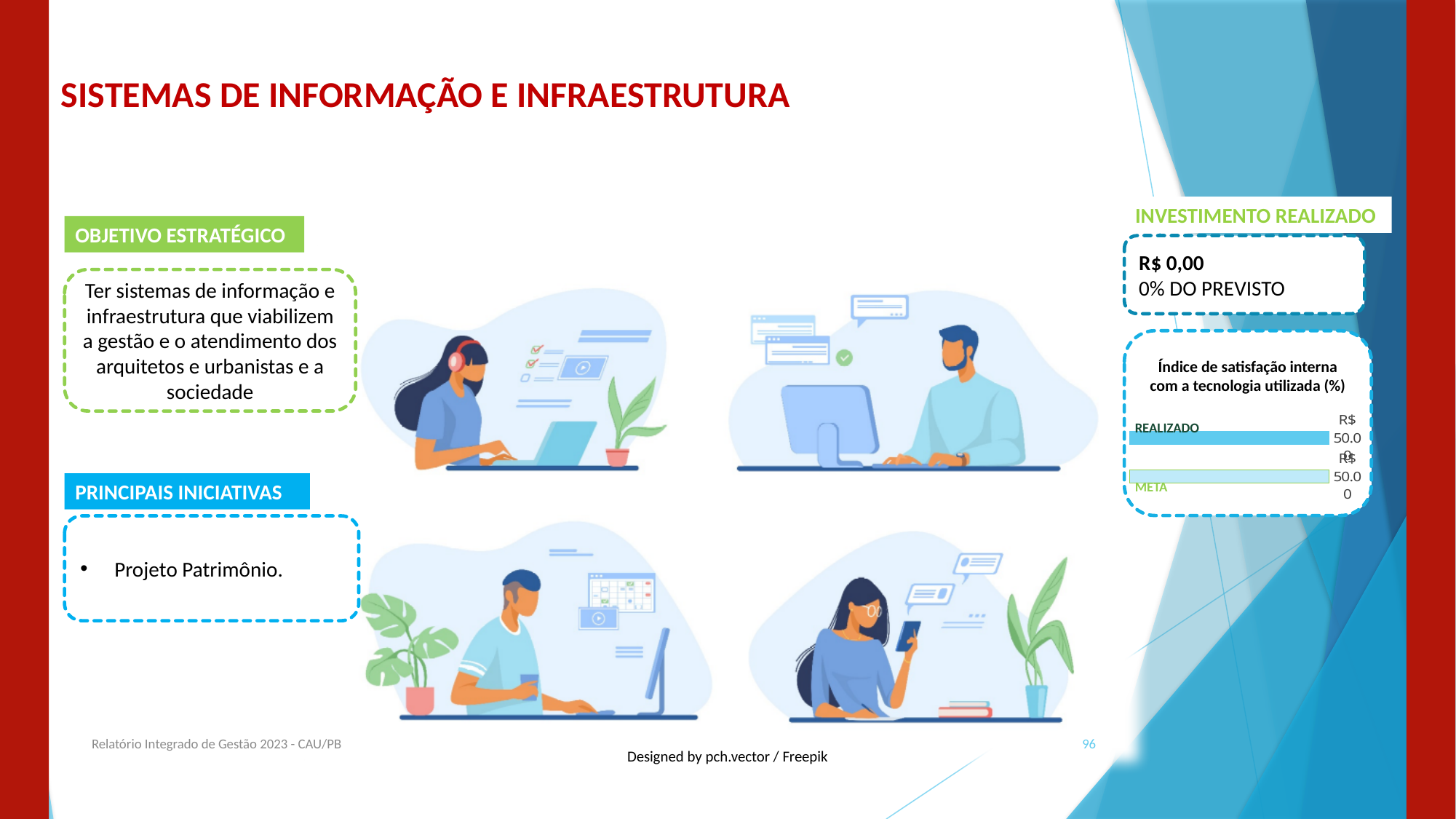
In the 'Índice de satisfação interna com a tecnologia utilizada (%)' chart, is the REALIZADO bar longer, shorter, or the same length as the META bar? the same length How many bars does the 'Índice de satisfação interna com a tecnologia utilizada (%)' chart show? 2 What kind of chart is shown under 'Índice de satisfação interna com a tecnologia utilizada (%)'? bar chart What is the title of the bar chart on the right side of the slide? Índice de satisfação interna com a tecnologia utilizada (%) In the 'Índice de satisfação interna com a tecnologia utilizada (%)' chart, what is the difference between the REALIZADO and META values? R$ 0.00 In the 'Índice de satisfação interna com a tecnologia utilizada (%)' chart, what value is labelled on the META bar? R$ 50.00 In the 'Índice de satisfação interna com a tecnologia utilizada (%)' chart, what value is labelled on the REALIZADO bar? R$ 50.00 Which bar is drawn at the top of the 'Índice de satisfação interna com a tecnologia utilizada (%)' chart, REALIZADO or META? REALIZADO What are the two categories plotted in the 'Índice de satisfação interna com a tecnologia utilizada (%)' chart? REALIZADO and META